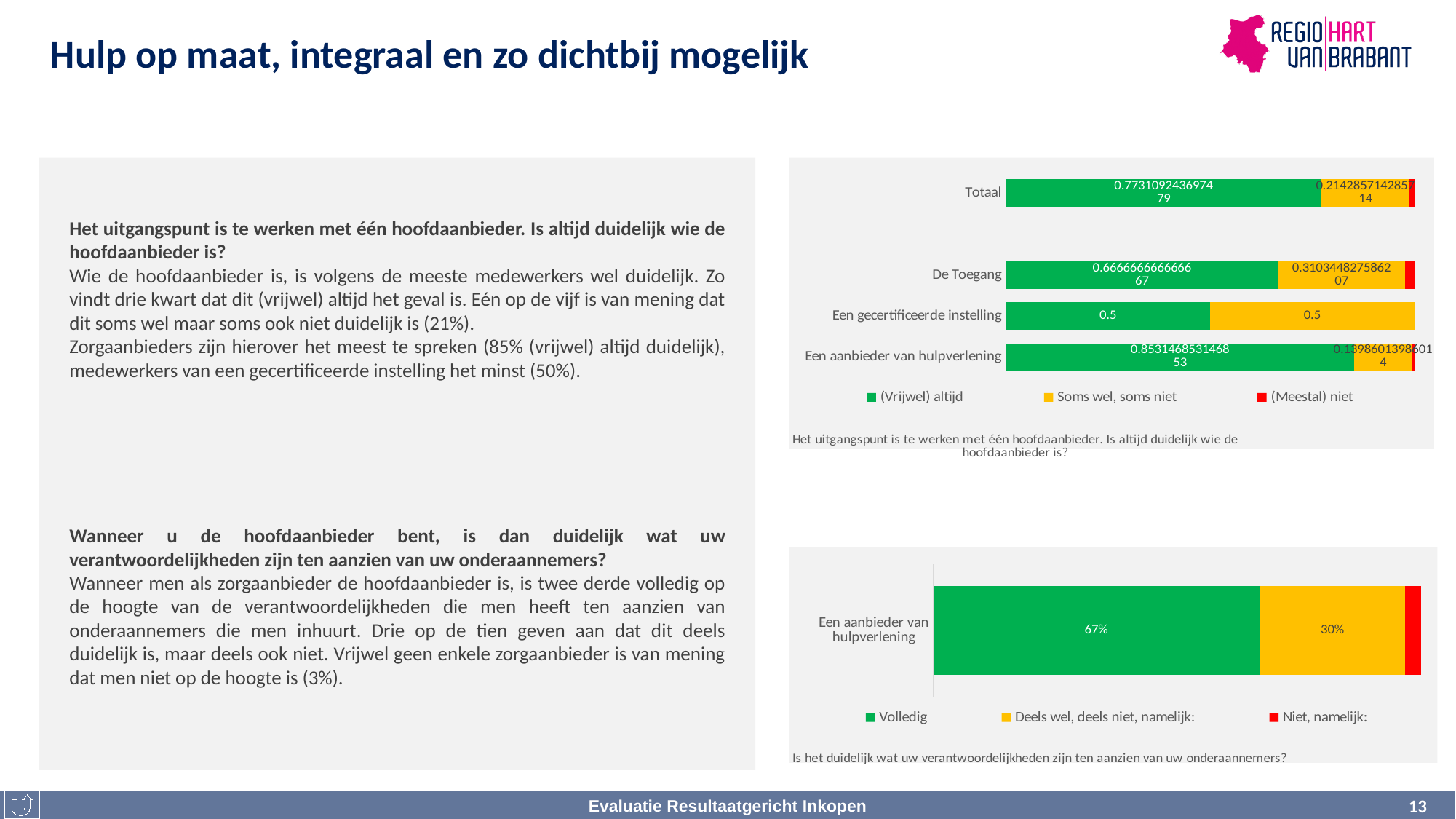
In the bottom chart, what is the value of 'Volledig' for 'Een aanbieder van hulpverlening'? 67% In the bottom chart, what is the difference between the 'Volledig' value and the 'Deels wel, deels niet, namelijk:' value? 37% In the top chart, which category has the highest '(Vrijwel) altijd' value? Een aanbieder van hulpverlening In the top chart, which has the larger '(Vrijwel) altijd' value: 'Totaal' or 'De Toegang'? Totaal In the bottom chart, what is the value of 'Deels wel, deels niet, namelijk:' for 'Een aanbieder van hulpverlening'? 30% What kind of chart is the top chart? Stacked bar chart How many series does the legend of the bottom chart list? 3 In the top chart, what is the value of '(Vrijwel) altijd' for 'Totaal'? 0.773109243697479 In the top chart, which category has the lowest '(Vrijwel) altijd' value? Een gecertificeerde instelling How many categories are shown in the top chart? 4 In the top chart, what is the value of '(Vrijwel) altijd' for 'Een gecertificeerde instelling'? 0.5 In the top chart, what is the value of 'Soms wel, soms niet' for 'Een gecertificeerde instelling'? 0.5